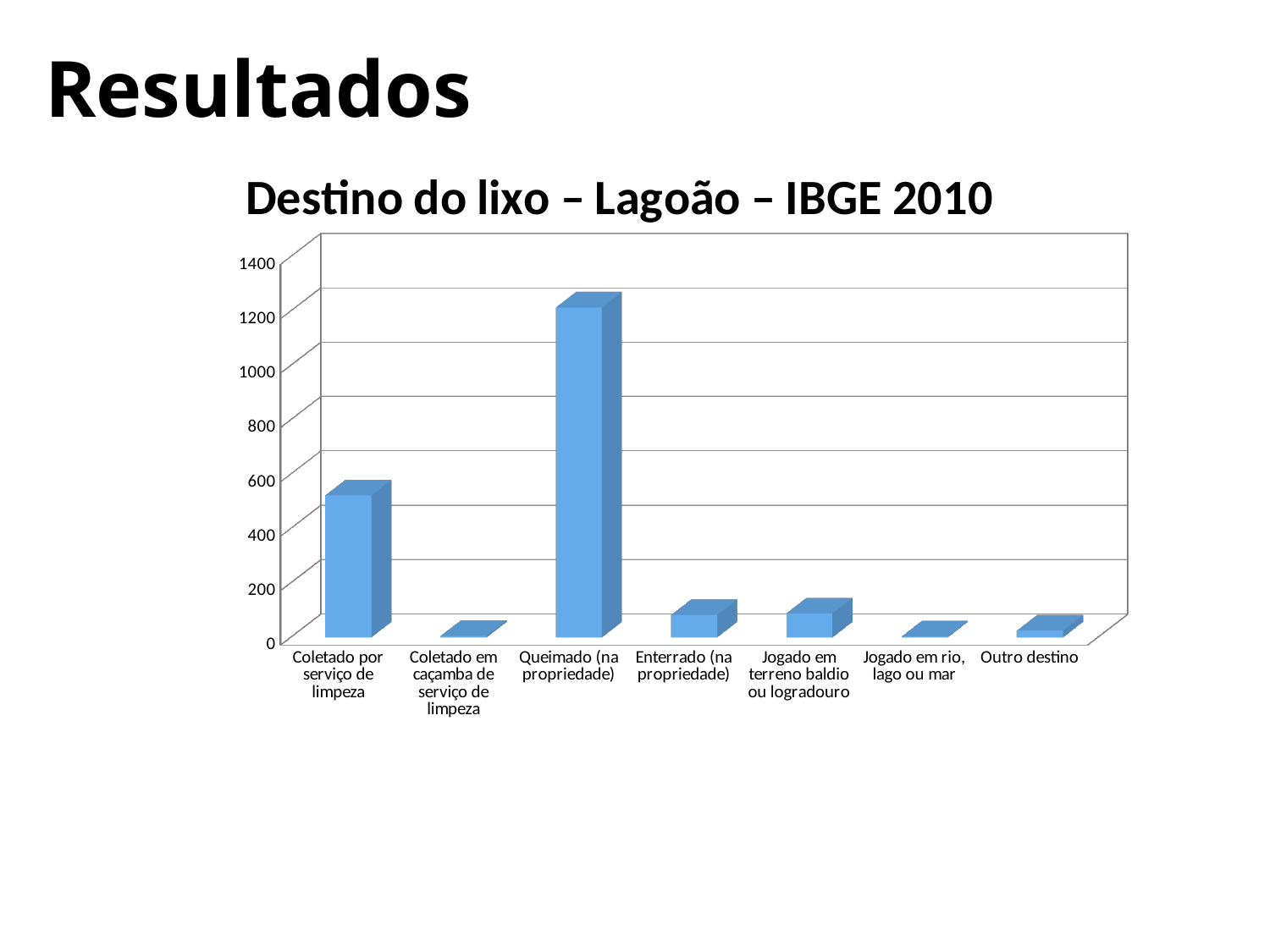
What kind of chart is shown on the slide? bar chart Is the value for Enterrado (na propriedade) greater or less than 200? less Which is larger, the value for Queimado (na propriedade) or the value for Coletado por serviço de limpeza? Queimado (na propriedade) Is the value for Coletado por serviço de limpeza greater or less than 600? less Is the value for Coletado por serviço de limpeza greater or less than 400? greater Which category has the highest value in the chart? Queimado (na propriedade) Which is larger, the value for Coletado por serviço de limpeza or the value for Enterrado (na propriedade)? Coletado por serviço de limpeza How many categories are shown on the x axis of the chart? 7 What is the title of the chart? Destino do lixo – Lagoão – IBGE 2010